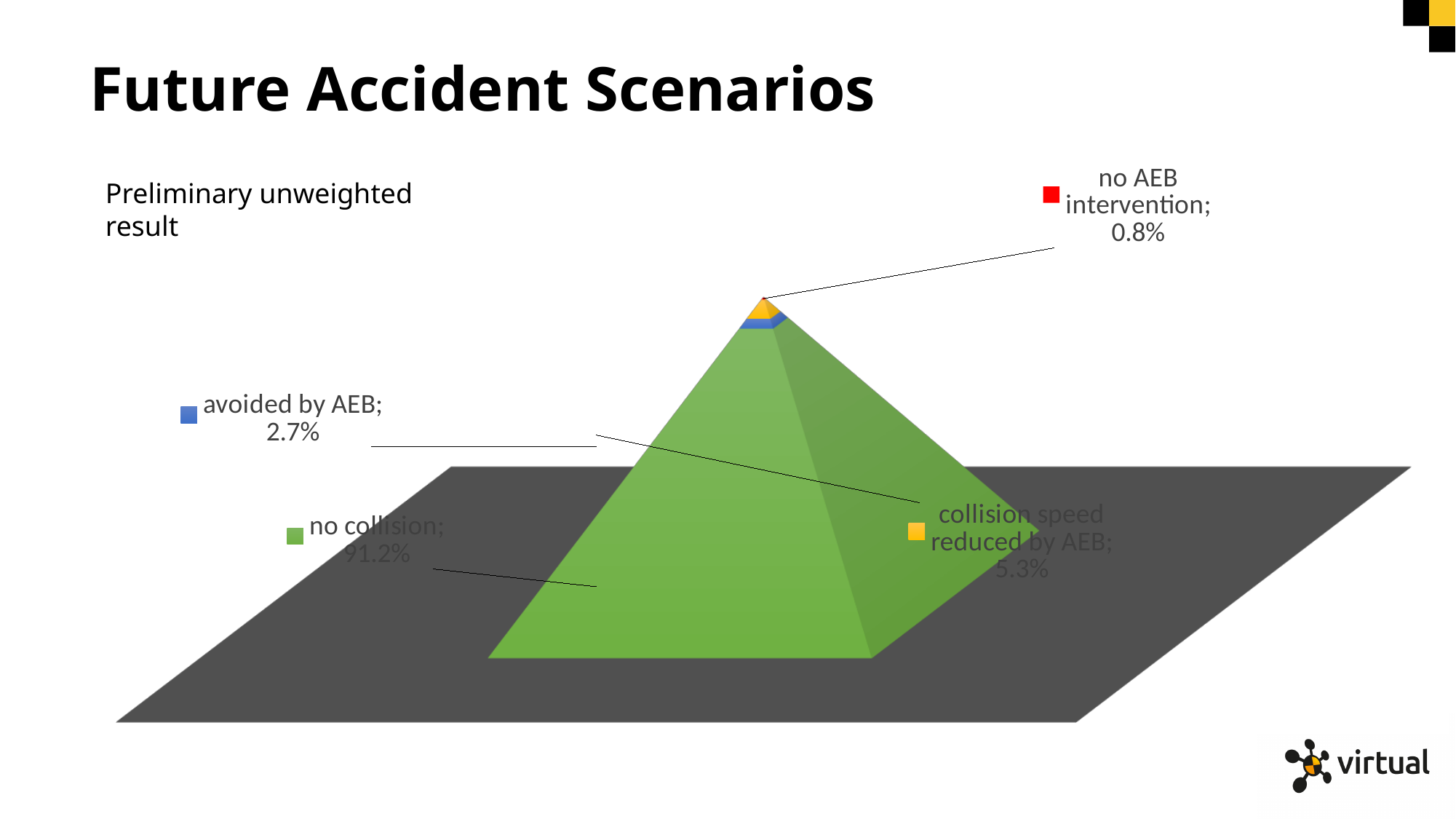
What is the difference between the 'collision speed reduced by AEB' and 'avoided by AEB' percentages? 2.6% Which is larger: 'avoided by AEB' or 'no AEB intervention'? avoided by AEB Which category has the smallest share? no AEB intervention What percentage is shown for 'collision speed reduced by AEB'? 5.3% Which category has the largest share? no collision What kind of chart is shown on the slide? pyramid chart What percentage is shown for 'no collision'? 91.2% What percentage is shown for 'no AEB intervention'? 0.8% How many categories are shown in the chart? 4 What text appears at the top left of the chart describing the result? Preliminary unweighted result What colour represents the 'no collision' category? green What percentage is shown for 'avoided by AEB'? 2.7%